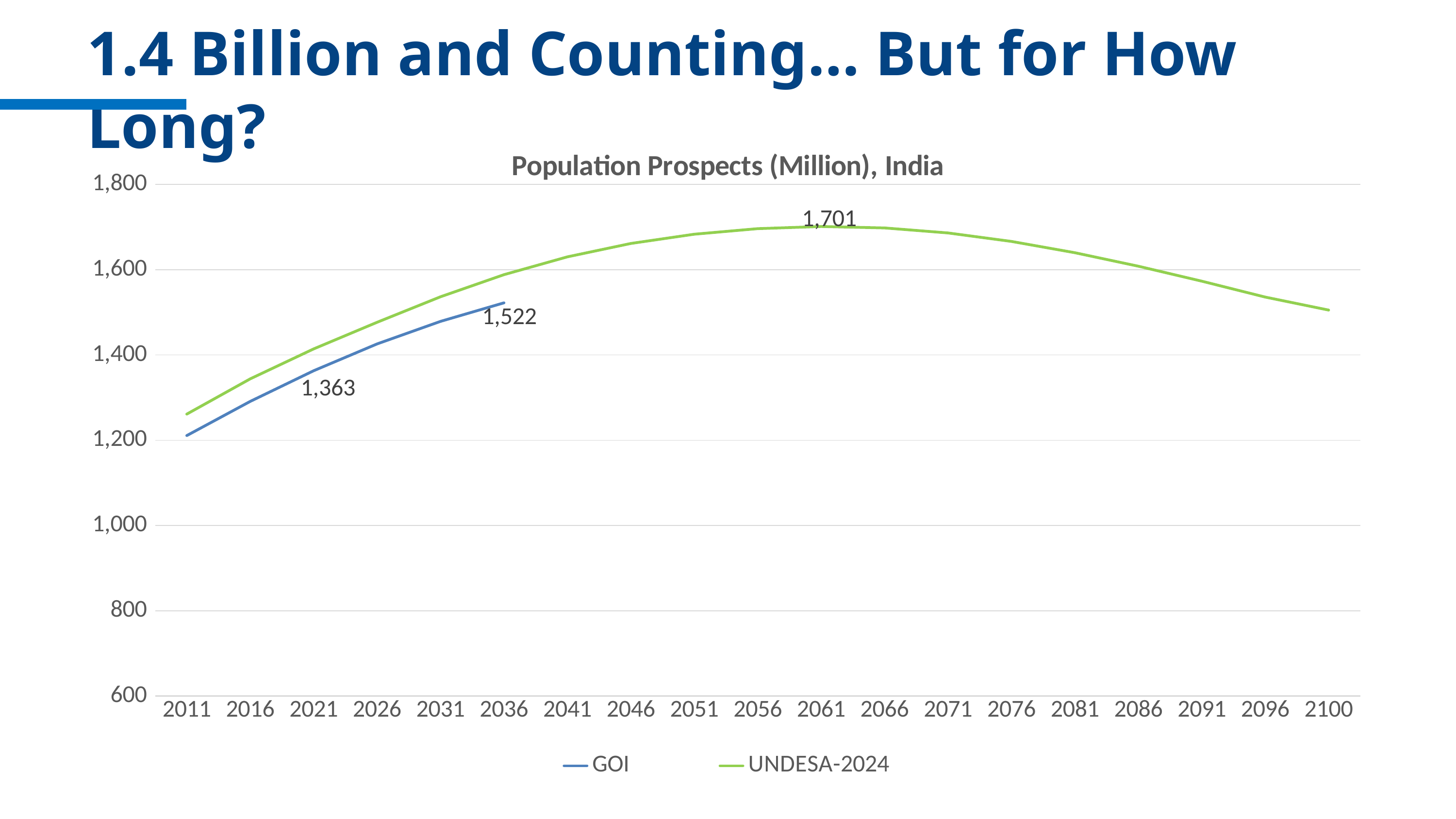
What type of chart is shown on the slide? line chart At 2021, which series has the higher value, GOI or UNDESA-2024? UNDESA-2024 What is the GOI value labelled at 2021? 1,363 What is the GOI value labelled at 2036? 1,522 How many year labels are shown on the x axis? 19 Is the UNDESA-2024 value at 2100 greater or less than 1,600? less What is the difference between the GOI values labelled at 2036 and 2021? 159 What is the title of the chart? Population Prospects (Million), India What is the peak value labelled on the UNDESA-2024 line? 1,701 Is the GOI value at 2011 greater or less than 1,400? less How many series does the legend list? 2 Does the GOI line rise or fall from 2011 to 2036? rise